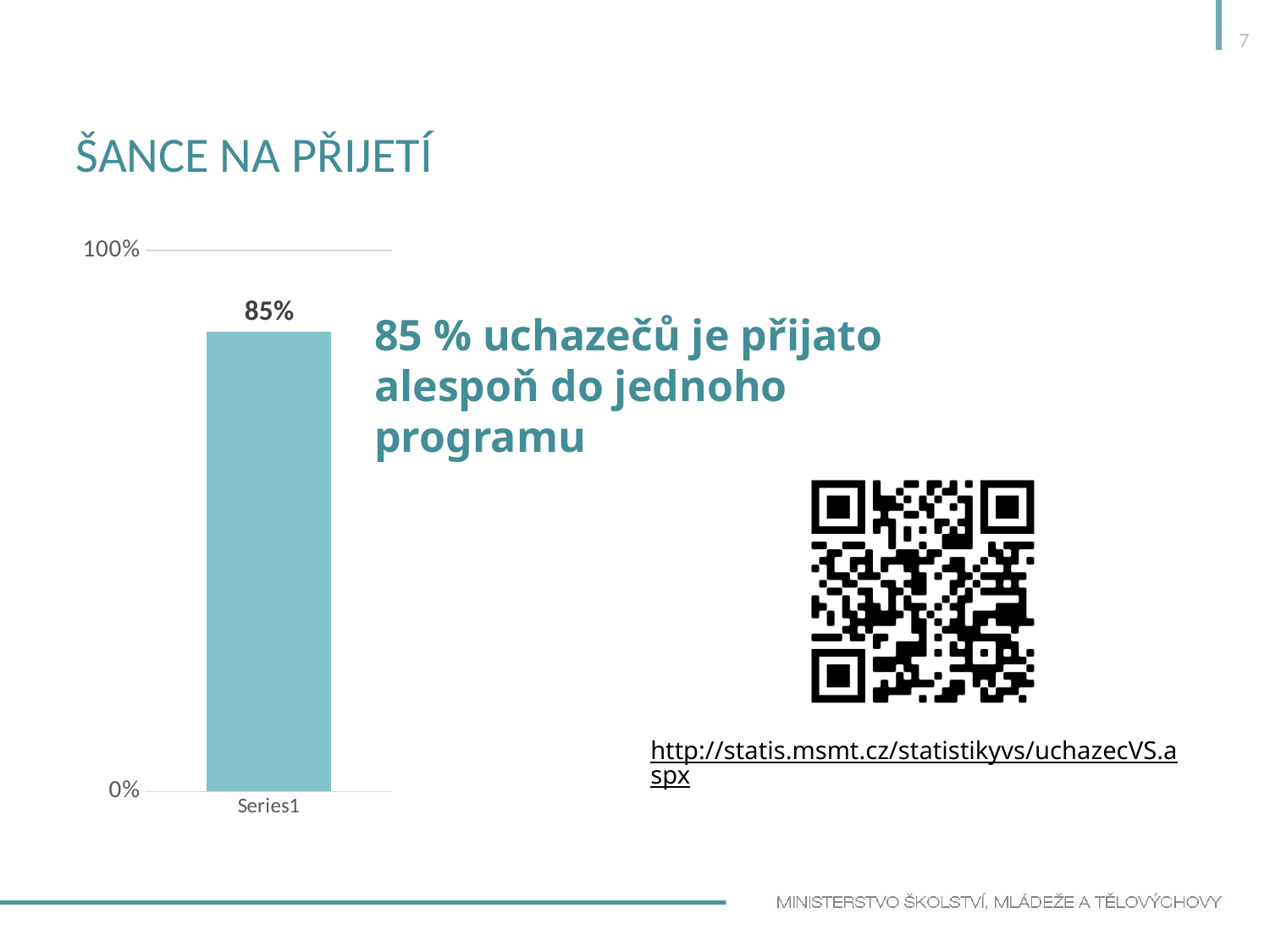
What is the label of the category on the x axis of the chart? Series1 What kind of chart is shown on the slide? bar chart What is the value shown for Series1 in the bar chart? 85% Is the value for Series1 greater or less than 50%? greater What is the highest value labelled on the y axis of the chart? 100% How many bars does the chart show? 1